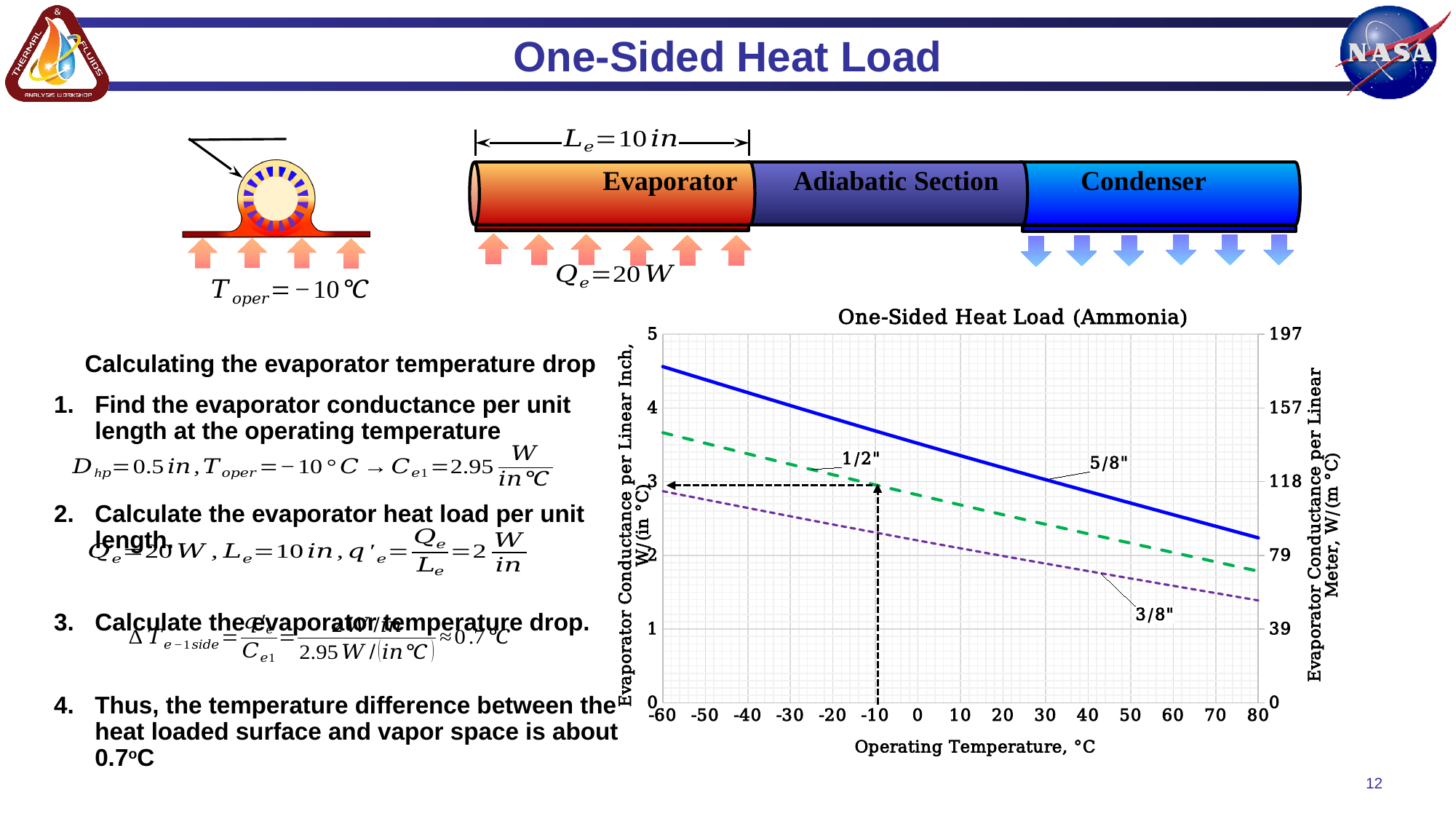
How many series (pipe diameters) are plotted on the chart? 3 Which series has the lowest evaporator conductance across the whole temperature range? 3/8" What is the label of the x axis of the chart? Operating Temperature, °C Which series has the highest evaporator conductance across the whole temperature range? 5/8" Do the evaporator conductance values rise or fall as operating temperature increases? fall Is the value for the 5/8" series at -60 °C greater or less than 4 W/(in °C)? greater What type of chart is shown on the slide? line chart Is the value for the 3/8" series at 80 °C greater or less than 2 W/(in °C)? less Is the value for the 5/8" series at 80 °C greater or less than 2 W/(in °C)? greater What is the title of the chart? One-Sided Heat Load (Ammonia) At 0 °C, which series has the larger evaporator conductance, 5/8" or 3/8"? 5/8"